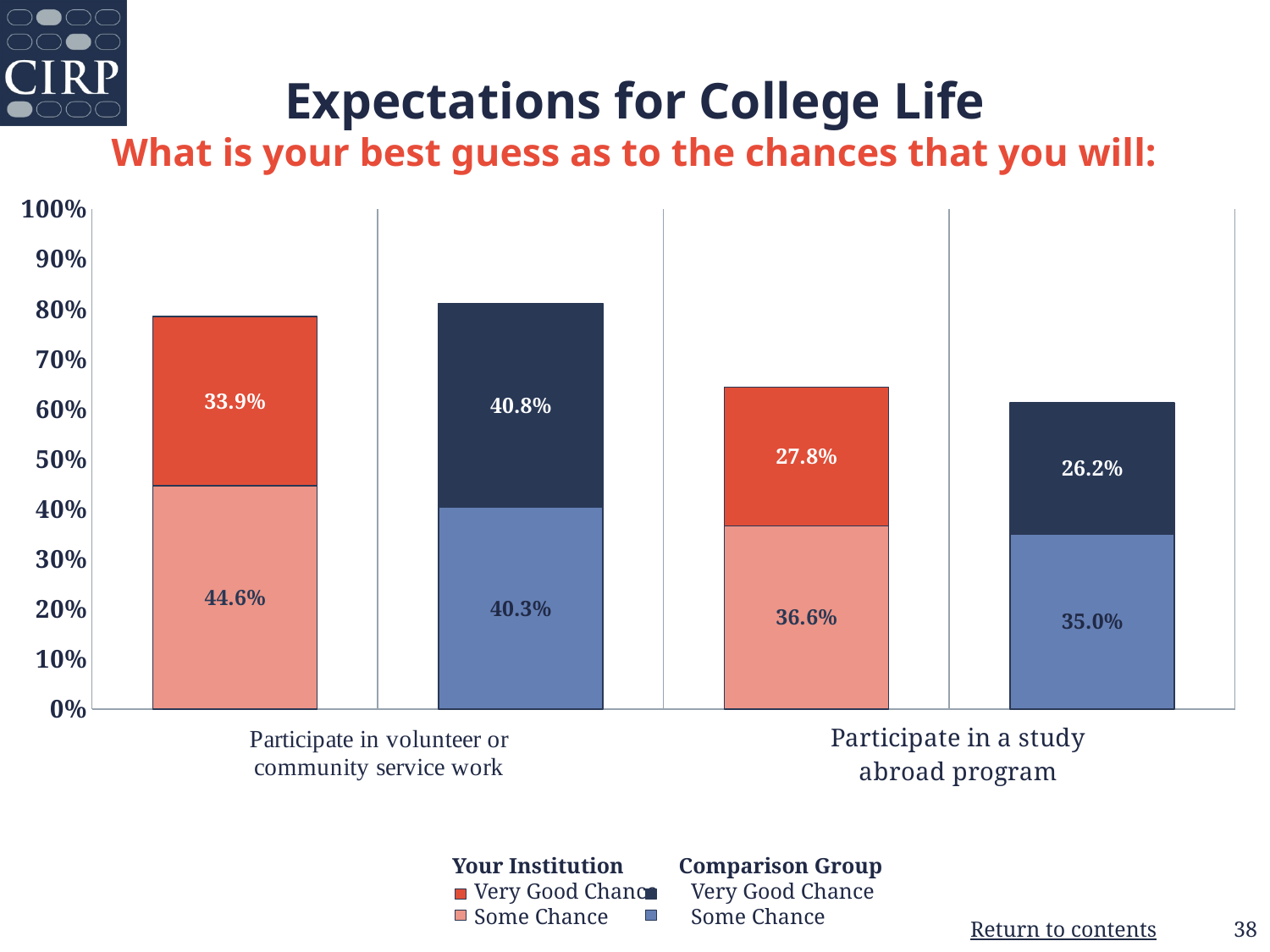
What is the total of the Comparison Group stacked bar for participating in a study abroad program? 61.2% What kind of chart is shown on the slide? Stacked bar chart What is the total of the Your Institution stacked bar for participating in volunteer or community service work? 78.5% What percentage of the Comparison Group said there is Some Chance they will participate in a study abroad program? 35.0% What is the difference between the Very Good Chance values for Your Institution and the Comparison Group for participating in volunteer or community service work? 6.9% What percentage of Your Institution students said there is a Very Good Chance they will participate in volunteer or community service work? 33.9% Which Some Chance segment is the highest across all bars? Your Institution, participate in volunteer or community service work (44.6%) How many series does the legend list? 4 What percentage of Your Institution students said there is Some Chance they will participate in a study abroad program? 36.6% What percentage of the Comparison Group said there is a Very Good Chance they will participate in volunteer or community service work? 40.8% Which is larger for participating in a study abroad program: the Some Chance value for Your Institution or for the Comparison Group? Your Institution Which Very Good Chance segment is the lowest across all bars? Comparison Group, participate in a study abroad program (26.2%)